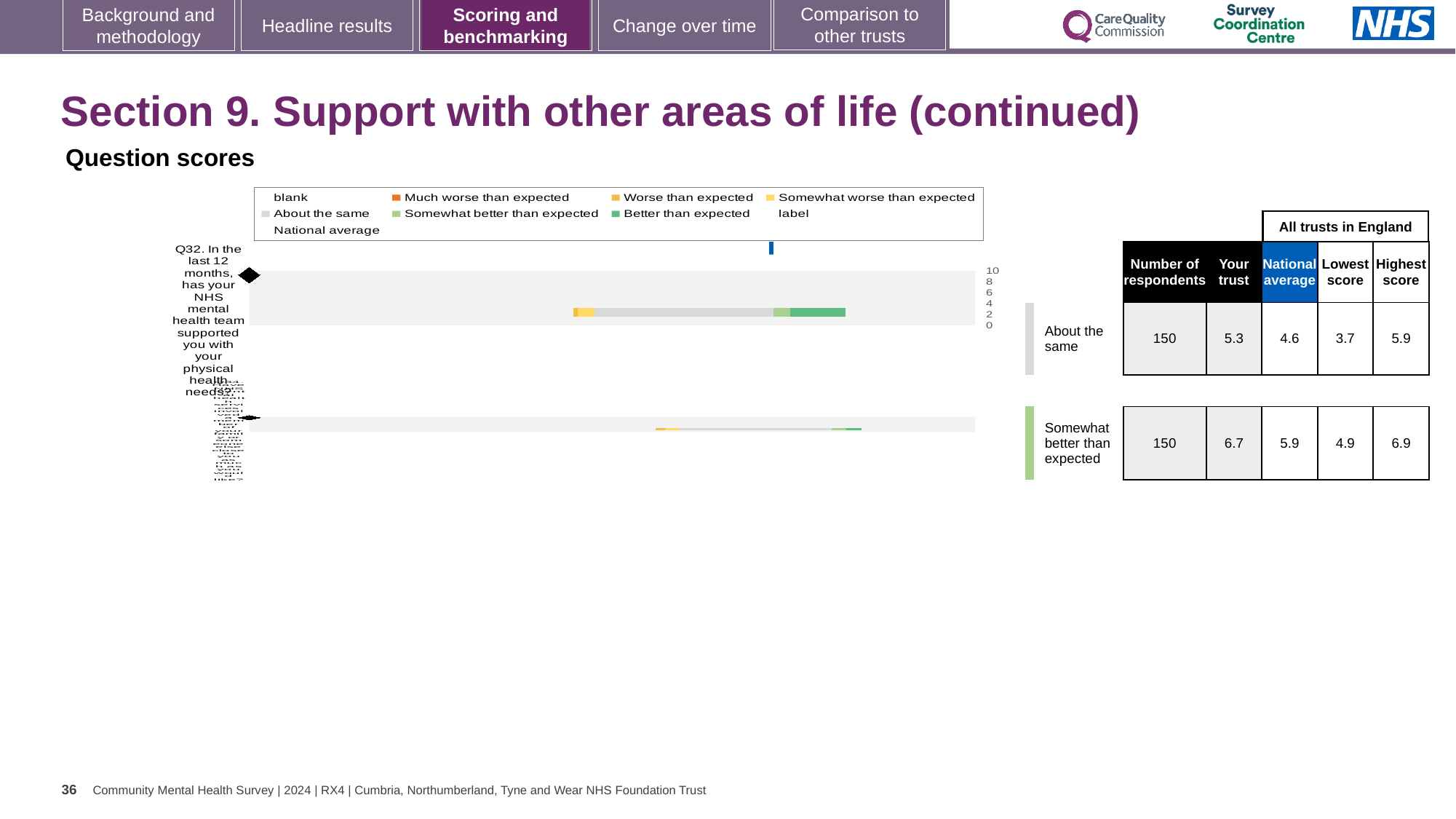
What is the lowest score among all trusts in England for the 'About the same' row (Q32)? 3.7 What is the maximum value shown on the chart's score axis? 10 For the 'Somewhat better than expected' row, which is larger: the 'Your trust' score or the national average? Your trust What colour does the legend use for 'Better than expected'? green In the table, what is the national average for the row labelled 'About the same' (Q32)? 4.6 In the table, what is the 'Your trust' score for the row labelled 'Somewhat better than expected'? 6.7 What kind of chart is shown on the slide? bar chart For the 'About the same' row (Q32), what is the difference between the 'Your trust' score and the national average? 0.7 In the table, what is the 'Your trust' score for the row labelled 'About the same' (Q32)? 5.3 How many respondents are listed for Q32 (the 'About the same' row)? 150 In the table, what is the highest score among all trusts in England for the row labelled 'Somewhat better than expected'? 6.9 For the 'Somewhat better than expected' row, what is the difference between the highest score and the lowest score among all trusts in England? 2.0